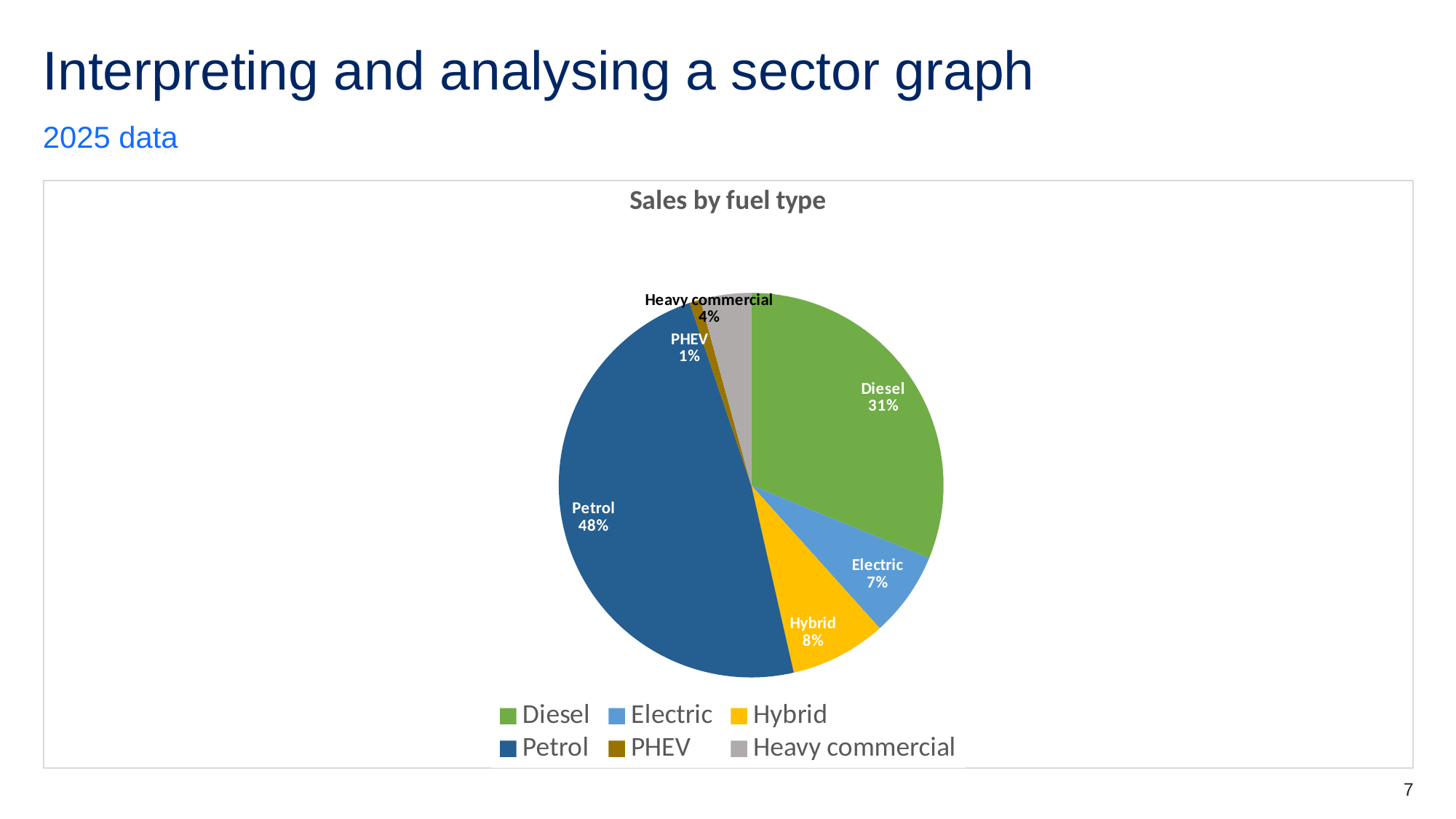
What share of sales is Diesel? 31% Which has the larger share, Hybrid or Electric? Hybrid What share of sales is Electric? 7% What share of sales is Heavy commercial? 4% What is the difference in percentage points between the Petrol and Diesel shares? 17 Which fuel type has the largest share of sales? Petrol What type of chart is shown on the slide? pie chart What colour is the Hybrid slice? yellow What is the title of the chart? Sales by fuel type How many fuel type categories are shown in the pie chart? 6 Which fuel type has the smallest share of sales? PHEV